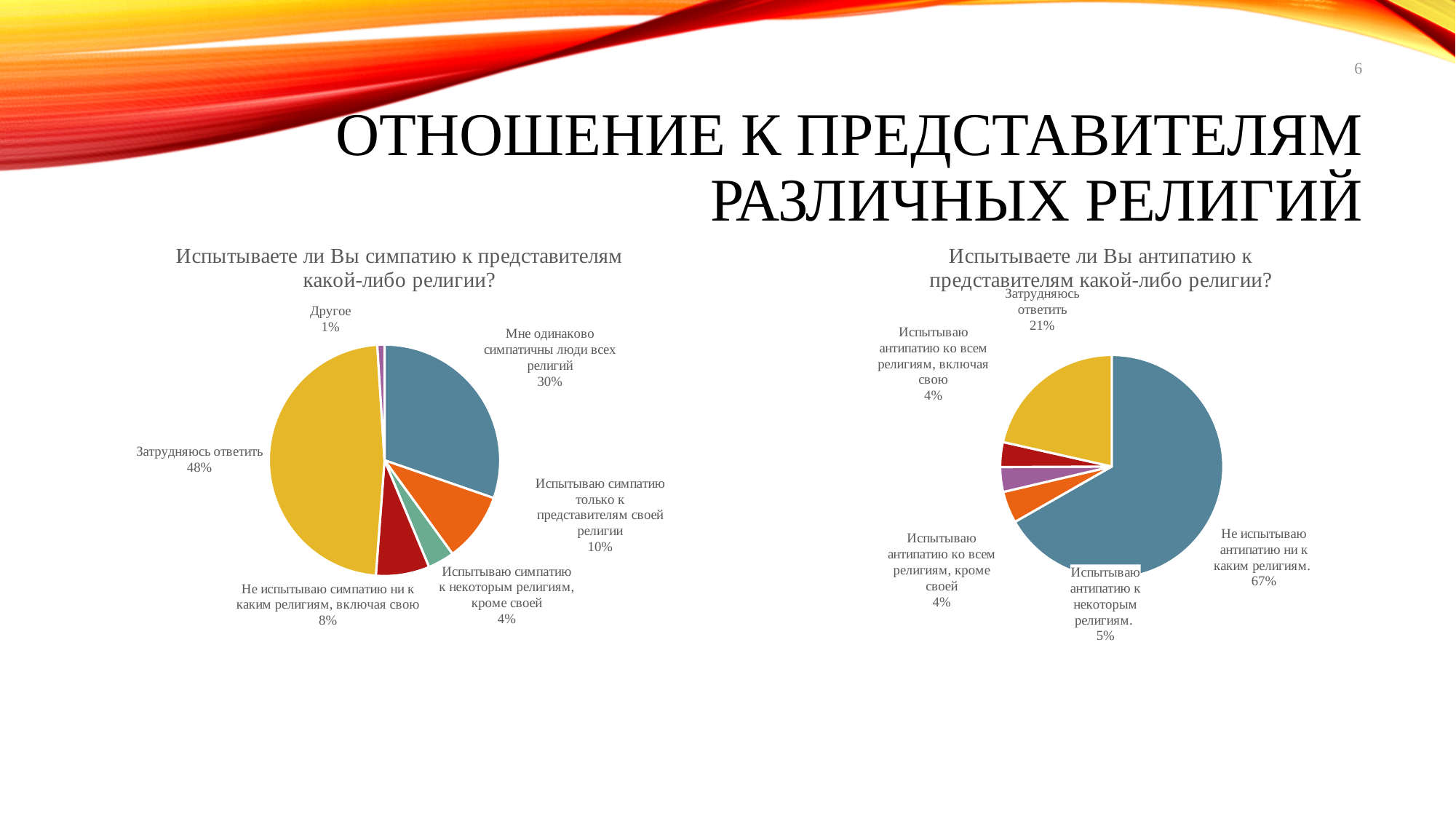
In the left chart ("Испытываете ли Вы симпатию..."), what share is labelled "Затрудняюсь ответить"? 48% In the left chart ("Испытываете ли Вы симпатию..."), which is larger: "Испытываю симпатию только к представителям своей религии" or "Не испытываю симпатию ни к каким религиям, включая свою"? Испытываю симпатию только к представителям своей религии In the right chart ("Испытываете ли Вы антипатию..."), what share is labelled "Не испытываю антипатию ни к каким религиям"? 67% In the left chart ("Испытываете ли Вы симпатию..."), which category has the smallest share? Другое In the left chart ("Испытываете ли Вы симпатию..."), how many slices does the pie have? 6 In the right chart ("Испытываете ли Вы антипатию..."), how many slices does the pie have? 5 What type of chart is used on the left side of the slide ("Испытываете ли Вы симпатию к представителям какой-либо религии?")? Pie chart In the right chart ("Испытываете ли Вы антипатию..."), which category has the largest share? Не испытываю антипатию ни к каким религиям In the left chart ("Испытываете ли Вы симпатию..."), what share is labelled "Мне одинаково симпатичны люди всех религий"? 30% In the left chart ("Испытываете ли Вы симпатию..."), what is the difference between "Затрудняюсь ответить" and "Мне одинаково симпатичны люди всех религий"? 18% In the right chart ("Испытываете ли Вы антипатию..."), what is the difference between "Не испытываю антипатию ни к каким религиям" and "Затрудняюсь ответить"? 46% In the right chart ("Испытываете ли Вы антипатию..."), what share is labelled "Затрудняюсь ответить"? 21%